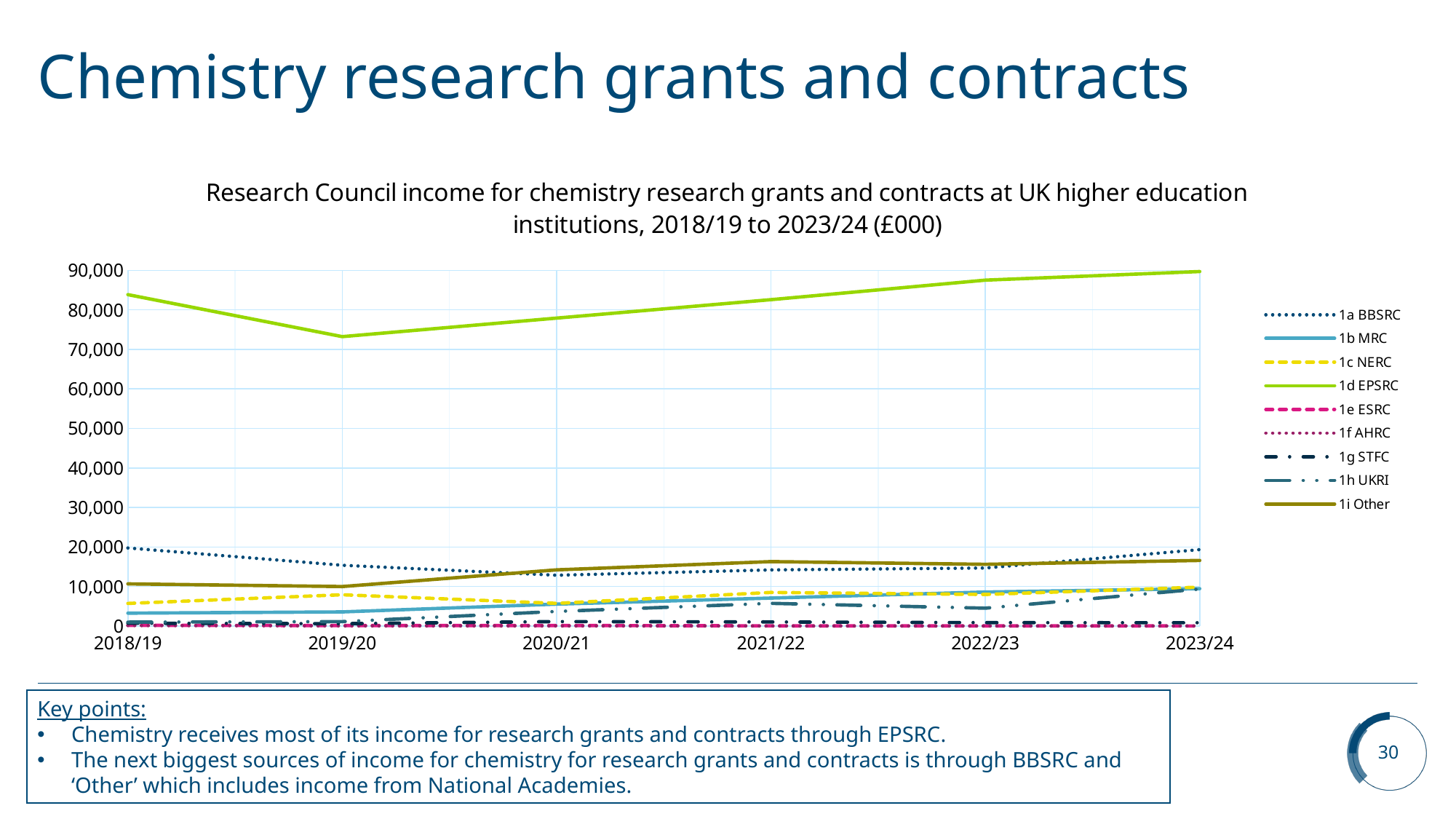
Is the value for 1i Other in 2021/22 greater or less than 10,000? greater Is the value for 1d EPSRC in 2023/24 greater or less than 80,000? greater How many series does the legend list? 9 Is the value for 1d EPSRC in 2019/20 greater or less than 80,000? less In which year is the 1d EPSRC line at its lowest? 2019/20 What kind of chart is shown on the slide? line chart Does the 1d EPSRC line rise or fall from 2019/20 to 2023/24? rise How many academic years are plotted along the x axis? 6 What unit is stated in the chart title for the values? £000 In 2018/19, which is larger: 1d EPSRC or 1a BBSRC? 1d EPSRC Which series has the highest value in 2023/24? 1d EPSRC